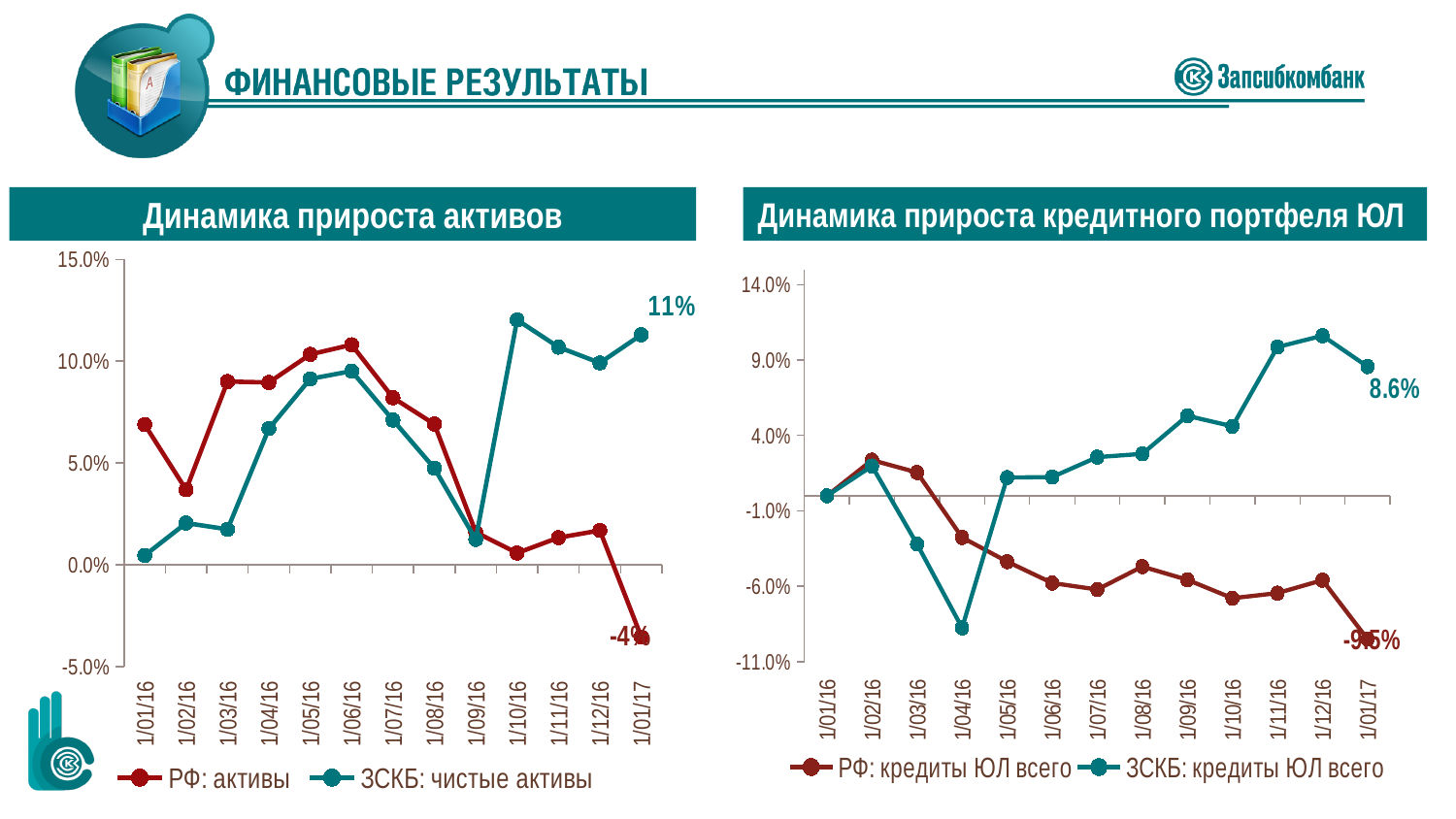
In the 'Динамика прироста кредитного портфеля ЮЛ' chart, which series has the higher value at 1/01/17? ЗСКБ: кредиты ЮЛ всего How many dates are shown on the x axis of the 'Динамика прироста активов' chart? 13 What kind of chart is the 'Динамика прироста активов' chart? line chart In the 'Динамика прироста активов' chart, what is the difference between the labelled values of 'ЗСКБ: чистые активы' and 'РФ: активы' at 1/01/17? 15 percentage points In the 'Динамика прироста кредитного портфеля ЮЛ' chart, is the value for 'ЗСКБ: кредиты ЮЛ всего' at 1/04/16 greater or less than -6.0%? less In the 'Динамика прироста активов' chart, what is the labelled value for 'ЗСКБ: чистые активы' at 1/01/17? 11% In the 'Динамика прироста кредитного портфеля ЮЛ' chart, does the 'РФ: кредиты ЮЛ всего' series generally rise or fall from 1/02/16 to 1/01/17? fall What are the two legend entries of the 'Динамика прироста кредитного портфеля ЮЛ' chart? РФ: кредиты ЮЛ всего; ЗСКБ: кредиты ЮЛ всего How many series does the legend of the 'Динамика прироста активов' chart list? 2 In the 'Динамика прироста кредитного портфеля ЮЛ' chart, what is the labelled value for 'ЗСКБ: кредиты ЮЛ всего' at 1/01/17? 8.6% In the 'Динамика прироста активов' chart, what is the labelled value for 'РФ: активы' at 1/01/17? -4% In the 'Динамика прироста активов' chart, is the value for 'ЗСКБ: чистые активы' at 1/10/16 greater or less than 10.0%? greater